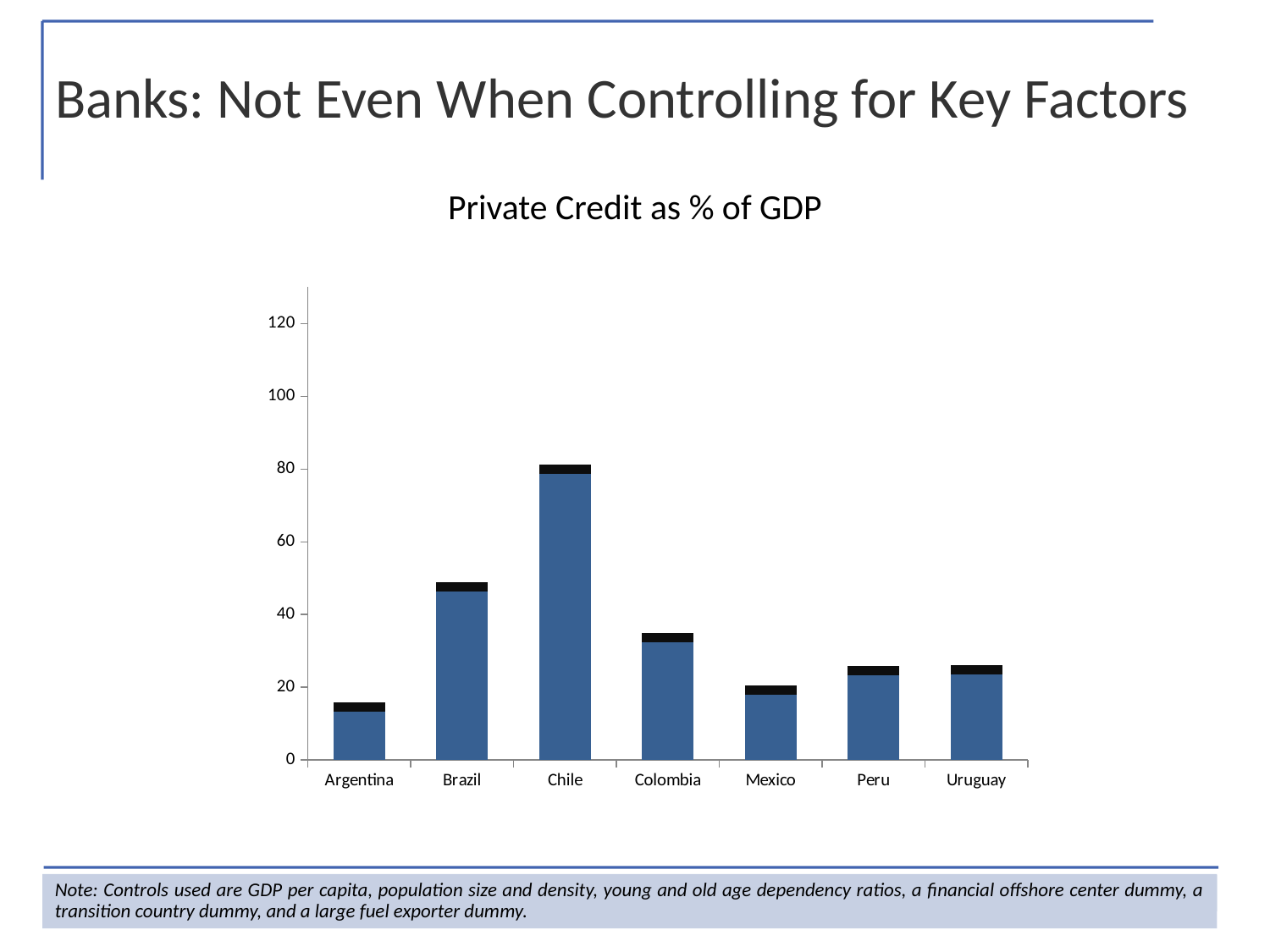
Is the value for Colombia greater or less than 40? less How many countries are shown on the x axis of the chart? 7 What is the title of the chart? Private Credit as % of GDP Is the value for Brazil greater or less than 60? less Is the value for Chile greater or less than 60? greater Which is larger, the bar for Mexico or the bar for Argentina? Mexico What type of chart is shown on the slide? bar chart Which is larger, the bar for Brazil or the bar for Colombia? Brazil Which country has the lowest bar in the chart? Argentina Which country has the highest bar in the chart? Chile